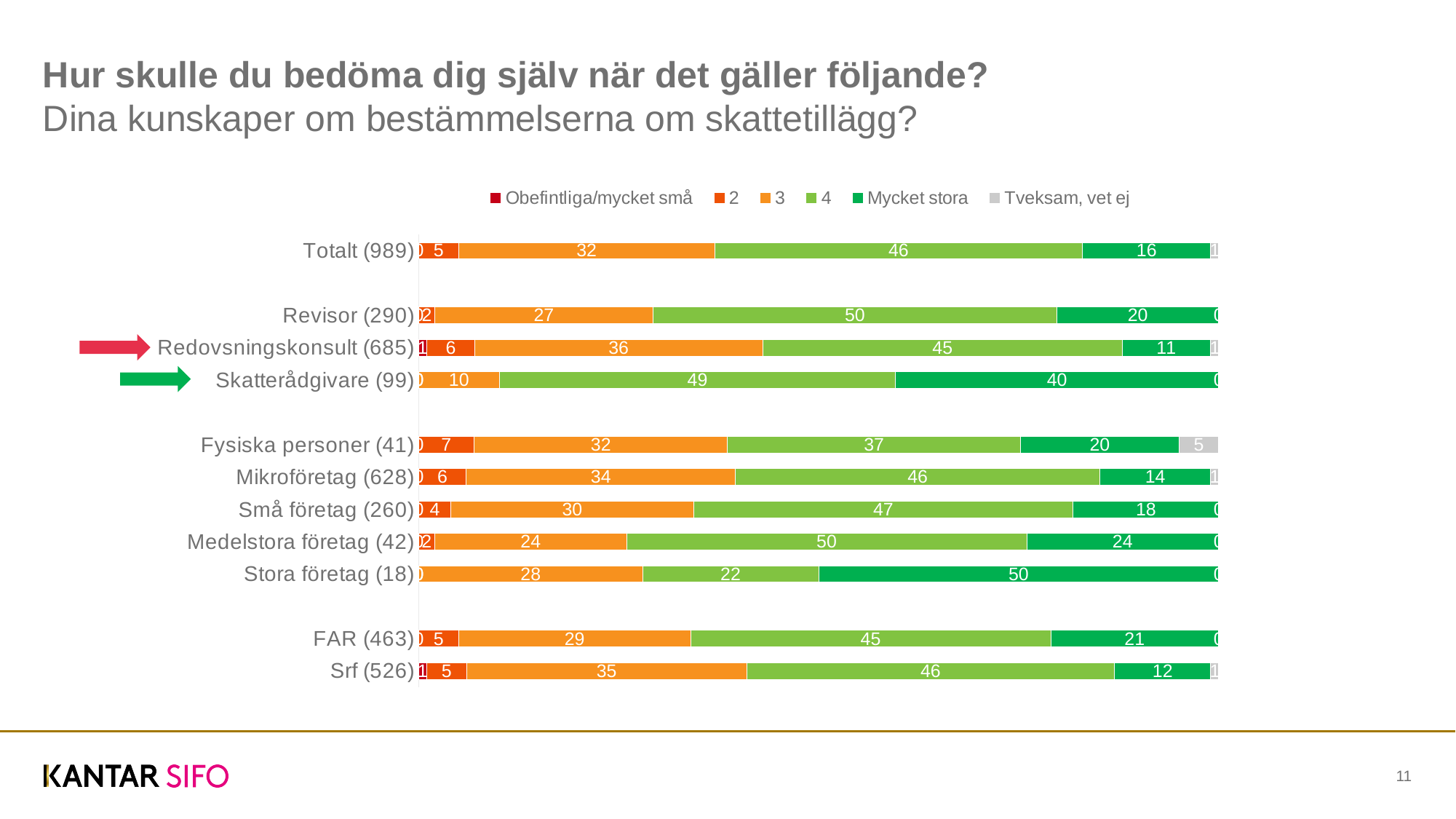
What is the difference between the "Mycket stora" values for Skatterådgivare (99) and Totalt (989)? 24 Which has a larger "3" value, Mikroföretag (628) or Små företag (260)? Mikroföretag (628) How many series does the legend list? 6 Which category has the highest "3" value? Redovsningskonsult (685) What kind of chart is shown on the slide? Stacked bar chart What is the value of the "Mycket stora" segment for Skatterådgivare (99)? 40 Which category has the lowest "Mycket stora" value? Redovsningskonsult (685) What is the value of the "Tveksam, vet ej" segment for Fysiska personer (41)? 5 Which category has the highest "Mycket stora" value? Stora företag (18) What is the value of the "4" segment for Revisor (290)? 50 What is the value of the "3" segment for Redovsningskonsult (685)? 36 How many categories (bars) are shown in the chart? 11